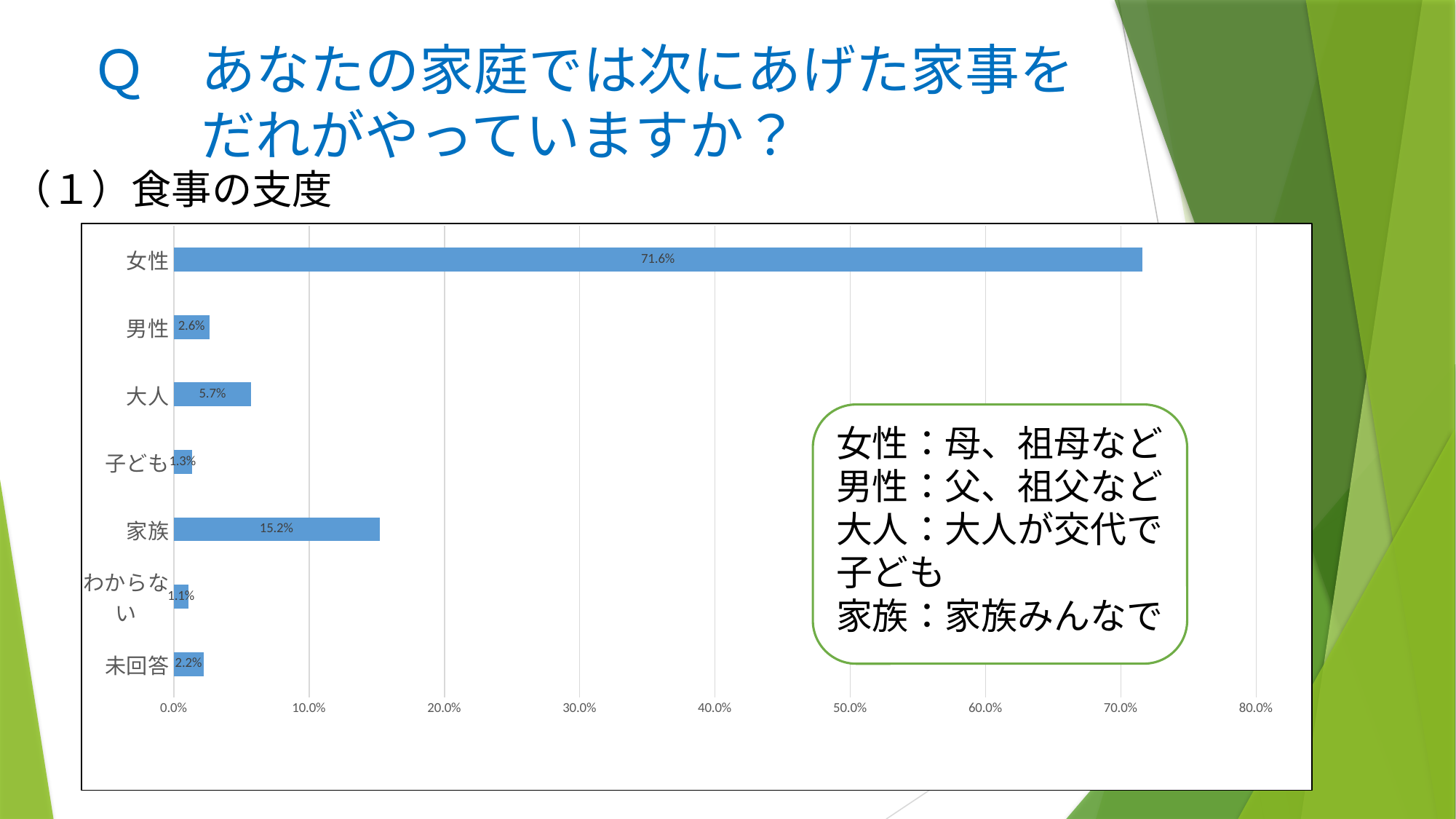
Is the value for 女性 greater or less than 70.0%? greater How many categories are shown in the chart? 7 What is the value for 家族 in the chart? 15.2% What kind of chart is shown on the slide? bar chart Which category has the lowest value in the chart? わからない What is the value for 大人 in the chart? 5.7% What is the value for 女性 in the chart? 71.6% What is the value for 未回答 in the chart? 2.2% What is the difference between the values for 女性 and 家族? 56.4% Which is larger, the value for 大人 or the value for 男性? 大人 Which category has the highest value in the chart? 女性 What is the value for 男性 in the chart? 2.6%